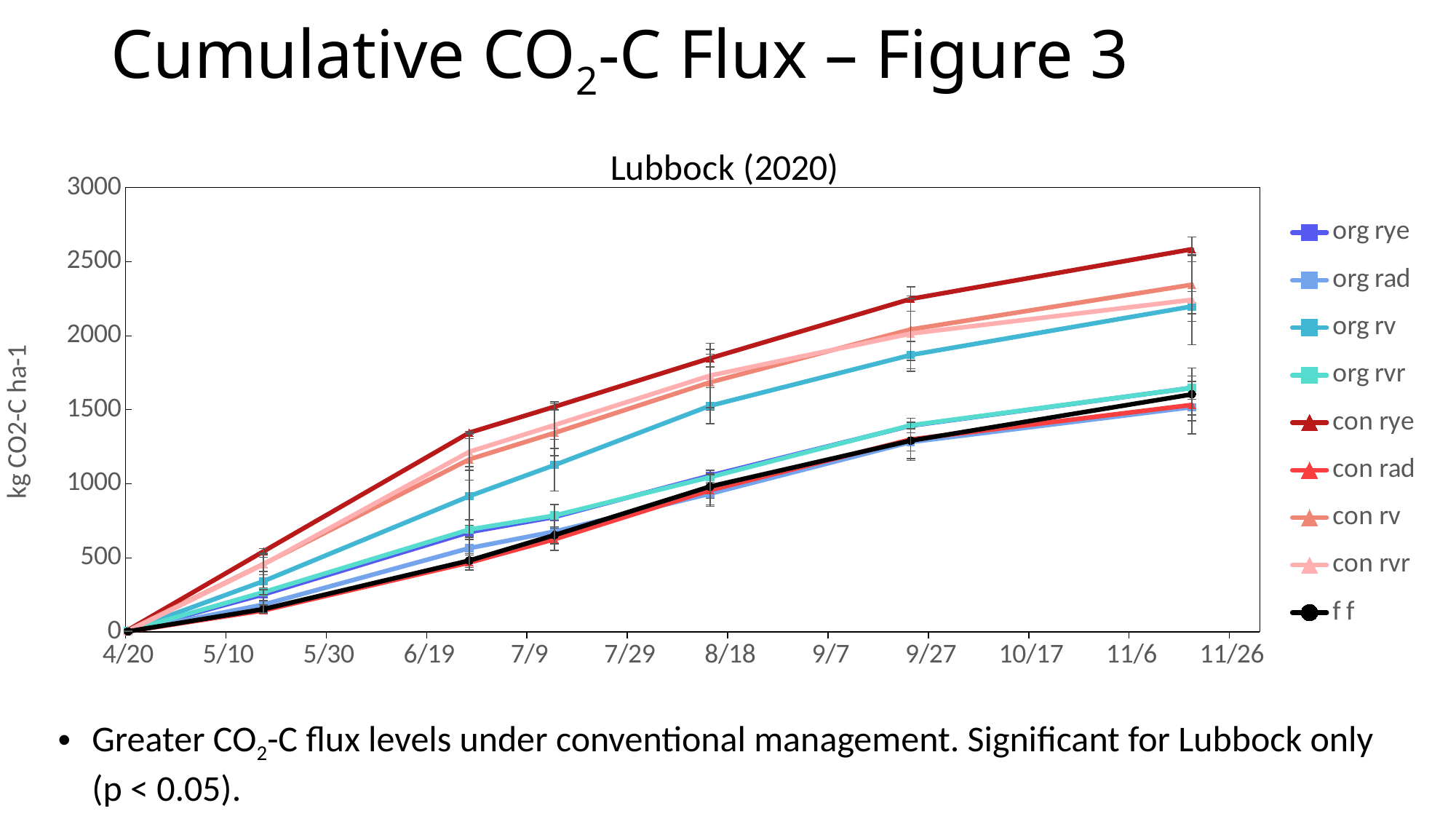
What kind of chart is shown on the slide? line chart Is the final value for org rv greater or less than 2000? greater At the final date, which is larger: con rye or f f? con rye How many series does the legend list? 9 Which series reaches the highest cumulative CO2-C flux at the final date? con rye What is the label on the y axis? kg CO2-C ha-1 At the final date, which is larger: org rv or org rye? org rv What is the title of the chart? Lubbock (2020) How many data points are plotted for each series? 7 Is the final value for con rye greater or less than 2000? greater Do the cumulative flux values rise or fall along the x axis? rise Is the final value for f f greater or less than 2000? less